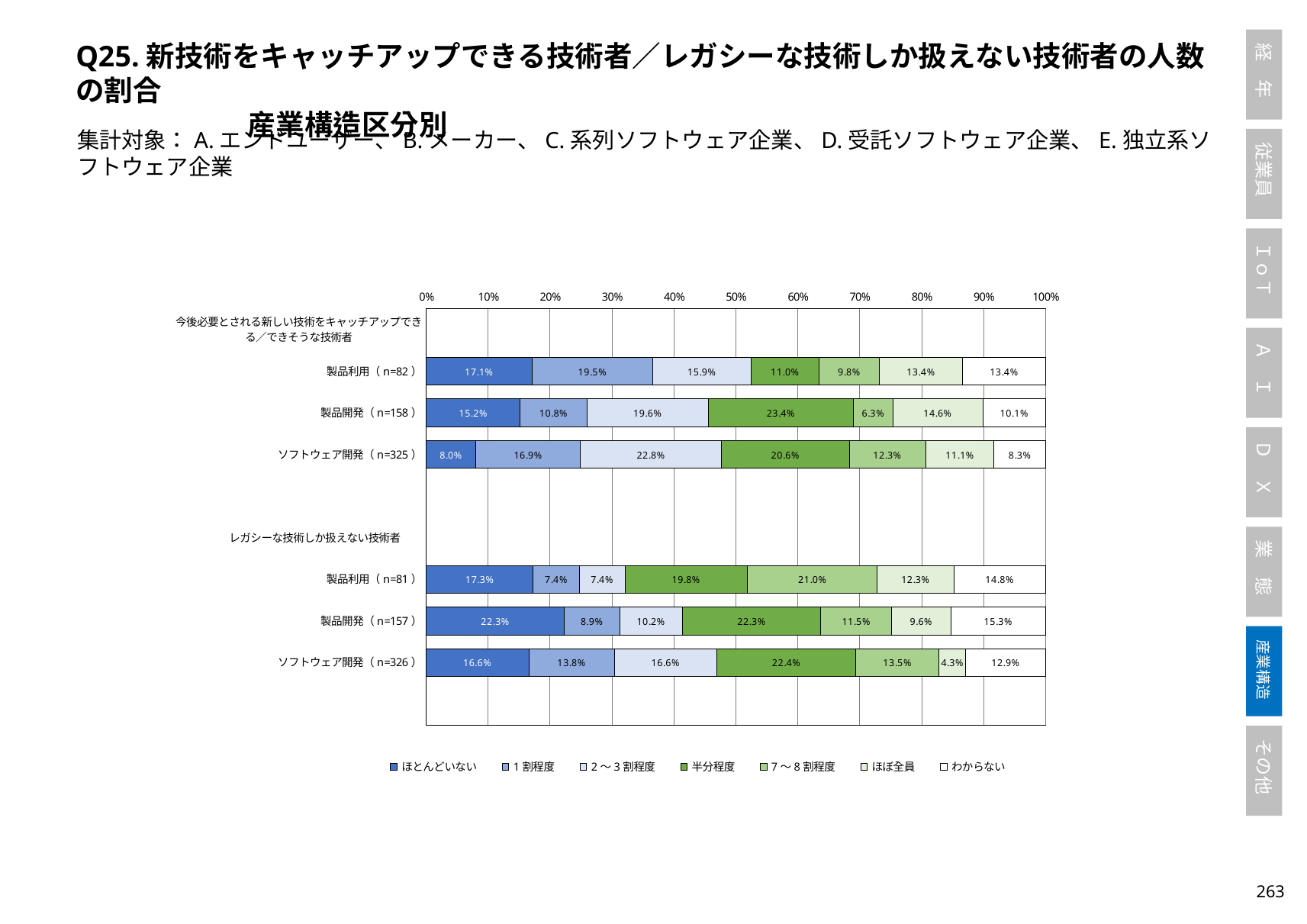
In the 今後必要とされる新しい技術をキャッチアップできる／できそうな技術者 group, which is larger for 製品利用 (n=82): 1割程度 or 半分程度? 1割程度 In the レガシーな技術しか扱えない技術者 group, what is the value of ほぼ全員 for ソフトウェア開発 (n=326)? 4.3% How many bars (rows with data) are plotted in the chart? 6 In the 今後必要とされる新しい技術をキャッチアップできる／できそうな技術者 group, what is the value of 半分程度 for 製品開発 (n=158)? 23.4% Among the three rows in the レガシーな技術しか扱えない技術者 group, which has the highest value for ほとんどいない? 製品開発 (n=157) In the 今後必要とされる新しい技術をキャッチアップできる／できそうな技術者 group, what is the value of ほとんどいない for 製品利用 (n=82)? 17.1% How many series does the legend list? 7 In the 今後必要とされる新しい技術をキャッチアップできる／できそうな技術者 group, what is the value of 2～3割程度 for ソフトウェア開発 (n=325)? 22.8% What kind of chart is shown on the slide? Stacked bar chart In the レガシーな技術しか扱えない技術者 group, what is the value of 7～8割程度 for 製品利用 (n=81)? 21.0% Among the three rows in the 今後必要とされる新しい技術をキャッチアップできる／できそうな技術者 group, which has the lowest value for ほとんどいない? ソフトウェア開発 (n=325) In the レガシーな技術しか扱えない技術者 group, what is the difference between the わからない values for 製品開発 (n=157) and ソフトウェア開発 (n=326)? 2.4%